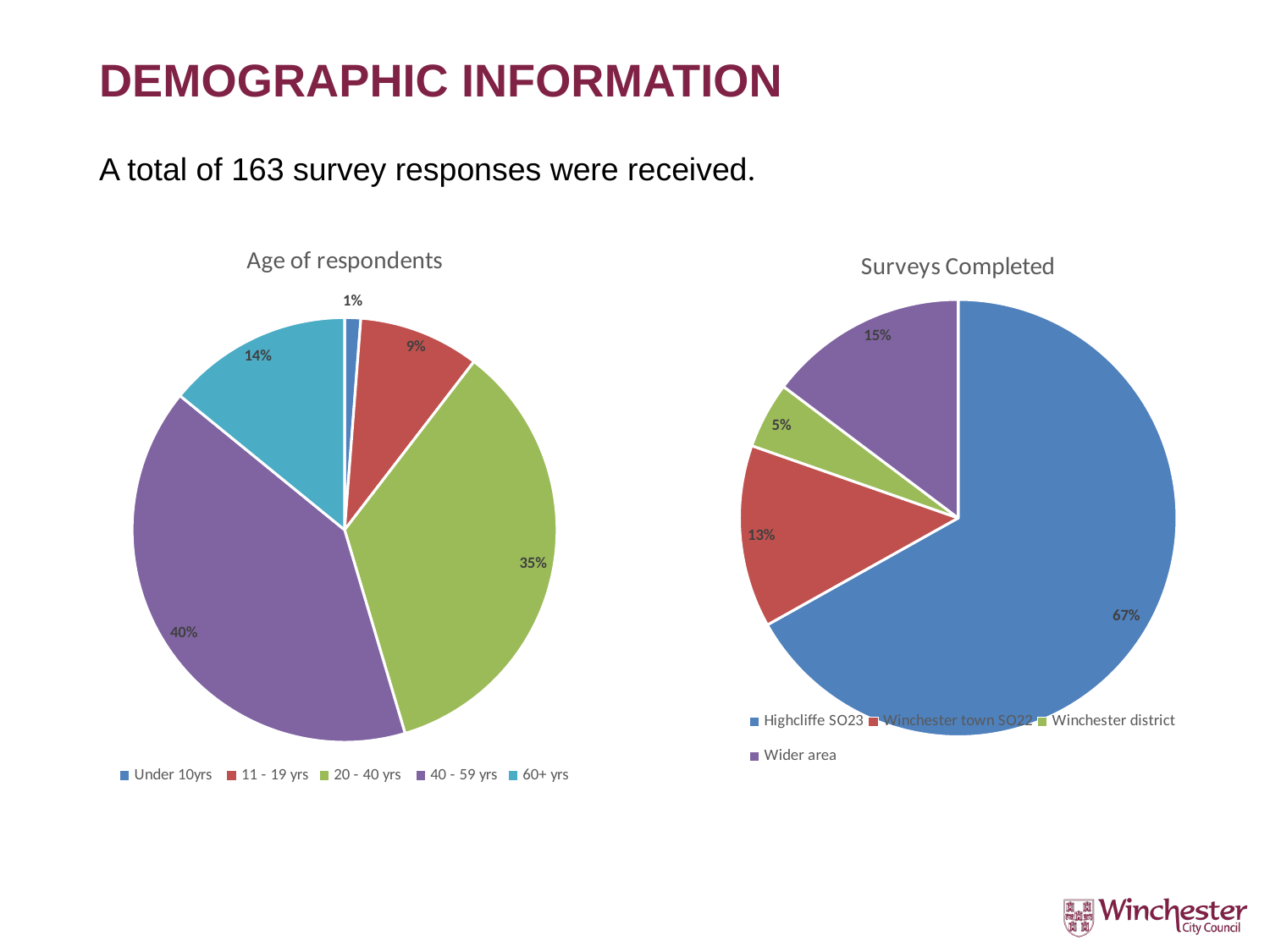
In the 'Surveys Completed' chart, which area has the smallest share? Winchester district In the 'Age of respondents' chart, what share of respondents are aged 40 - 59 yrs? 40% In the 'Surveys Completed' chart, what share of surveys came from Highcliffe SO23? 67% In the 'Age of respondents' chart, which age group has the smallest share? Under 10yrs In the 'Surveys Completed' chart, what percentage of surveys came from the Wider area? 15% In the 'Surveys Completed' chart, which is larger: Winchester town SO22 or Wider area? Wider area What type of chart is the 'Surveys Completed' chart? Pie chart In the 'Age of respondents' chart, which age group has the largest share? 40 - 59 yrs In the 'Age of respondents' chart, what percentage of respondents are aged 20 - 40 yrs? 35% In the 'Age of respondents' chart, how many age categories are shown? 5 In the 'Surveys Completed' chart, how many entries does the legend list? 4 In the 'Age of respondents' chart, what is the difference in percentage points between the 60+ yrs and 11 - 19 yrs slices? 5